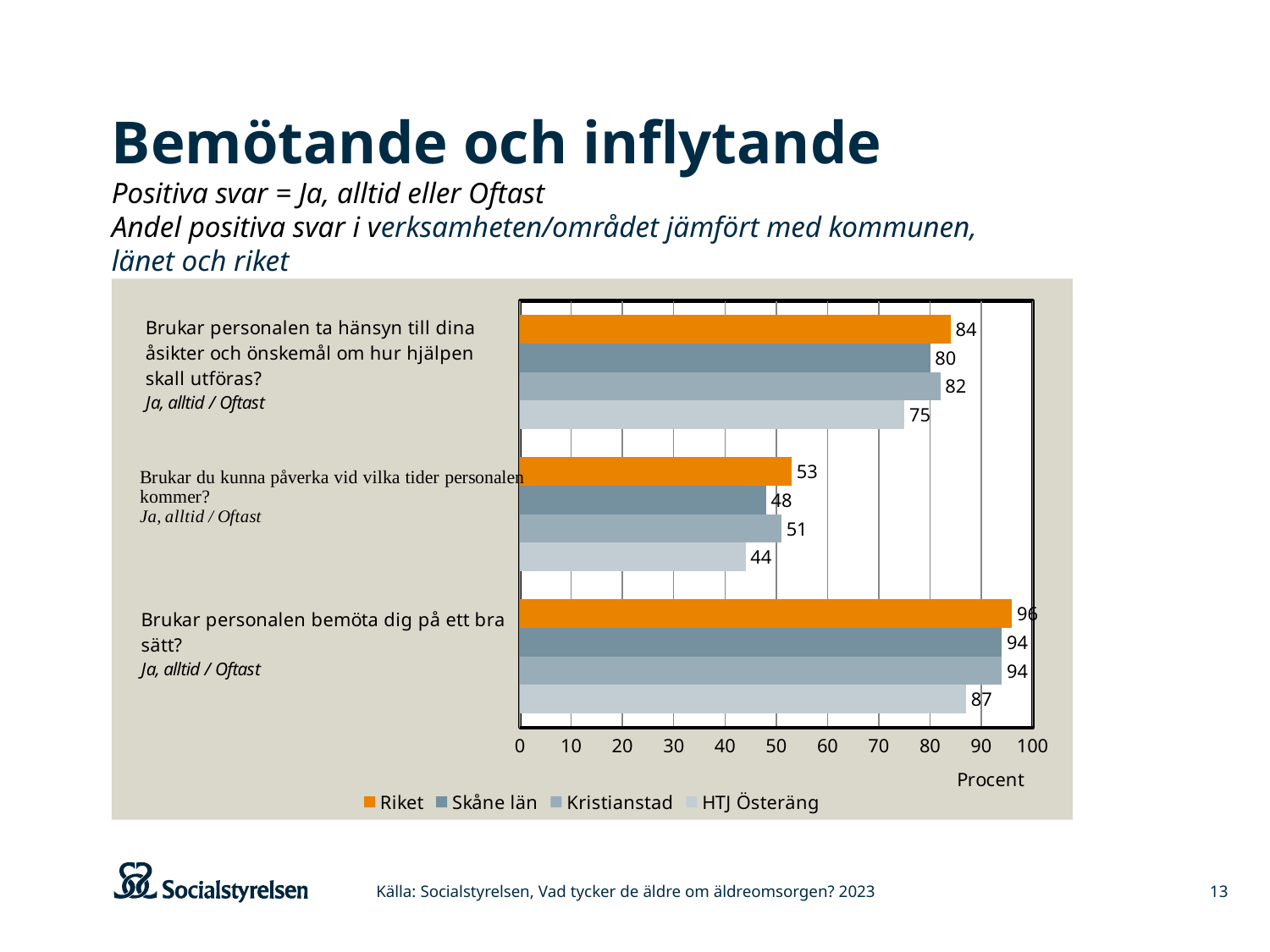
What is the value for HTJ Österäng on the question "Brukar du kunna påverka vid vilka tider personalen kommer?" 44 How many question categories are plotted on the chart? 3 What is the label on the horizontal axis of the chart? Procent How many series does the legend list? 4 Which series has the highest value on the question "Brukar personalen ta hänsyn till dina åsikter och önskemål om hur hjälpen skall utföras?" Riket What is the value for Kristianstad on the question "Brukar personalen ta hänsyn till dina åsikter och önskemål om hur hjälpen skall utföras?" 82 Which series has the lowest value on the question "Brukar personalen bemöta dig på ett bra sätt?" HTJ Österäng What is the difference between Riket and HTJ Österäng on the question "Brukar personalen bemöta dig på ett bra sätt?" 9 What is the value for Riket on the question "Brukar personalen bemöta dig på ett bra sätt?" 96 On the question "Brukar du kunna påverka vid vilka tider personalen kommer?", which is larger, Riket or Kristianstad? Riket What kind of chart is shown on the slide? bar chart What is the value for Skåne län on the question "Brukar du kunna påverka vid vilka tider personalen kommer?" 48